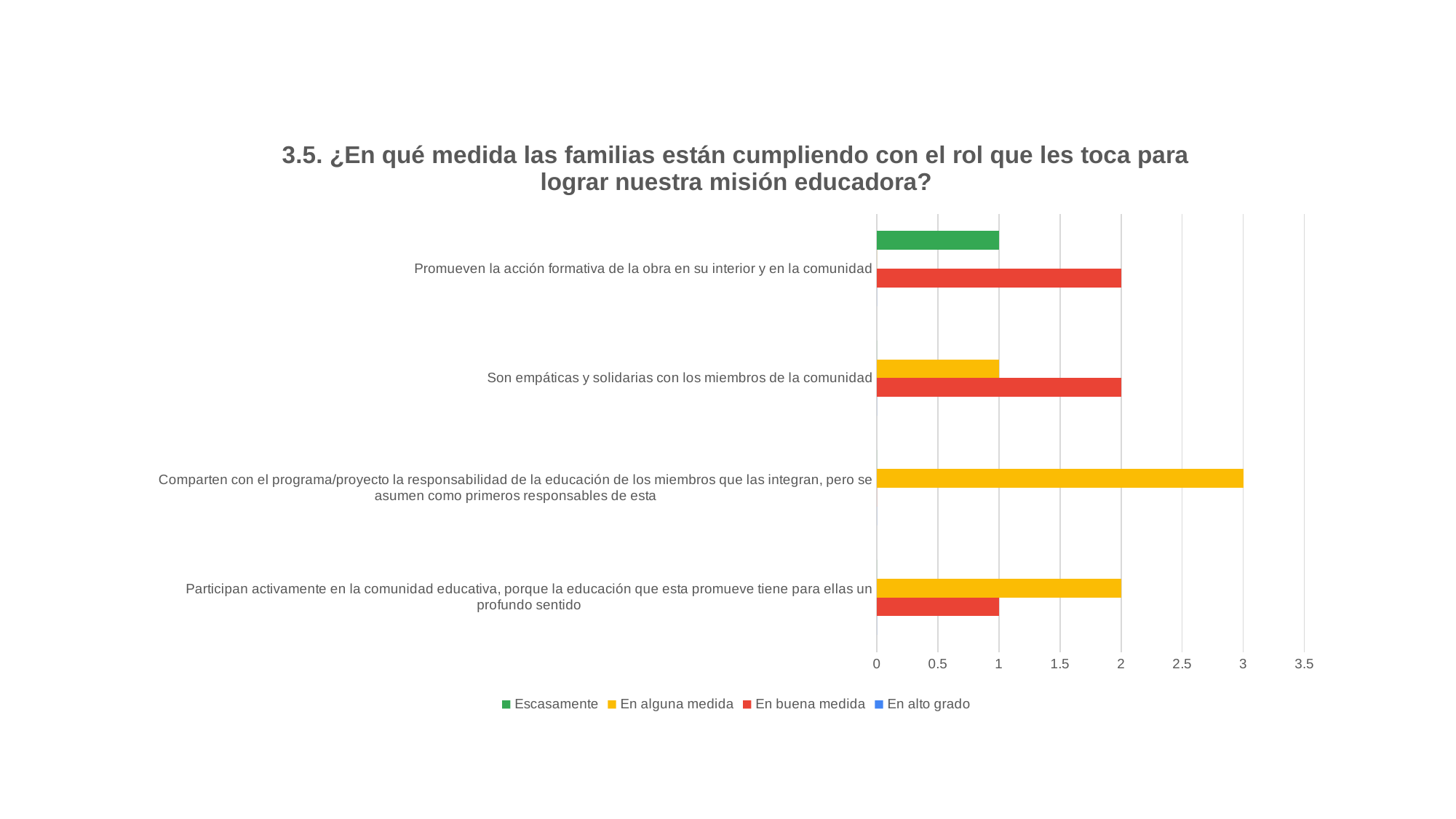
What is the value of 'En alguna medida' for 'Comparten con el programa/proyecto la responsabilidad de la educación de los miembros que las integran, pero se asumen como primeros responsables de esta'? 3 Which legend entry is shown in green? Escasamente Which category has the longest bar on the chart? Comparten con el programa/proyecto la responsabilidad de la educación de los miembros que las integran, pero se asumen como primeros responsables de esta What is the difference between 'En alguna medida' and 'En buena medida' for 'Participan activamente en la comunidad educativa, porque la educación que esta promueve tiene para ellas un profundo sentido'? 1 How many categories are plotted on the chart? 4 What is the value of 'En alguna medida' for 'Participan activamente en la comunidad educativa, porque la educación que esta promueve tiene para ellas un profundo sentido'? 2 What is the value of 'En buena medida' for 'Promueven la acción formativa de la obra en su interior y en la comunidad'? 2 What kind of chart is shown on the slide? bar chart For 'Son empáticas y solidarias con los miembros de la comunidad', which is larger: 'En alguna medida' or 'En buena medida'? En buena medida What is the value of 'Escasamente' for 'Promueven la acción formativa de la obra en su interior y en la comunidad'? 1 How many series does the legend list? 4 Is the value of 'En alguna medida' for 'Comparten con el programa/proyecto la responsabilidad de la educación de los miembros que las integran, pero se asumen como primeros responsables de esta' greater or less than 2.5? greater